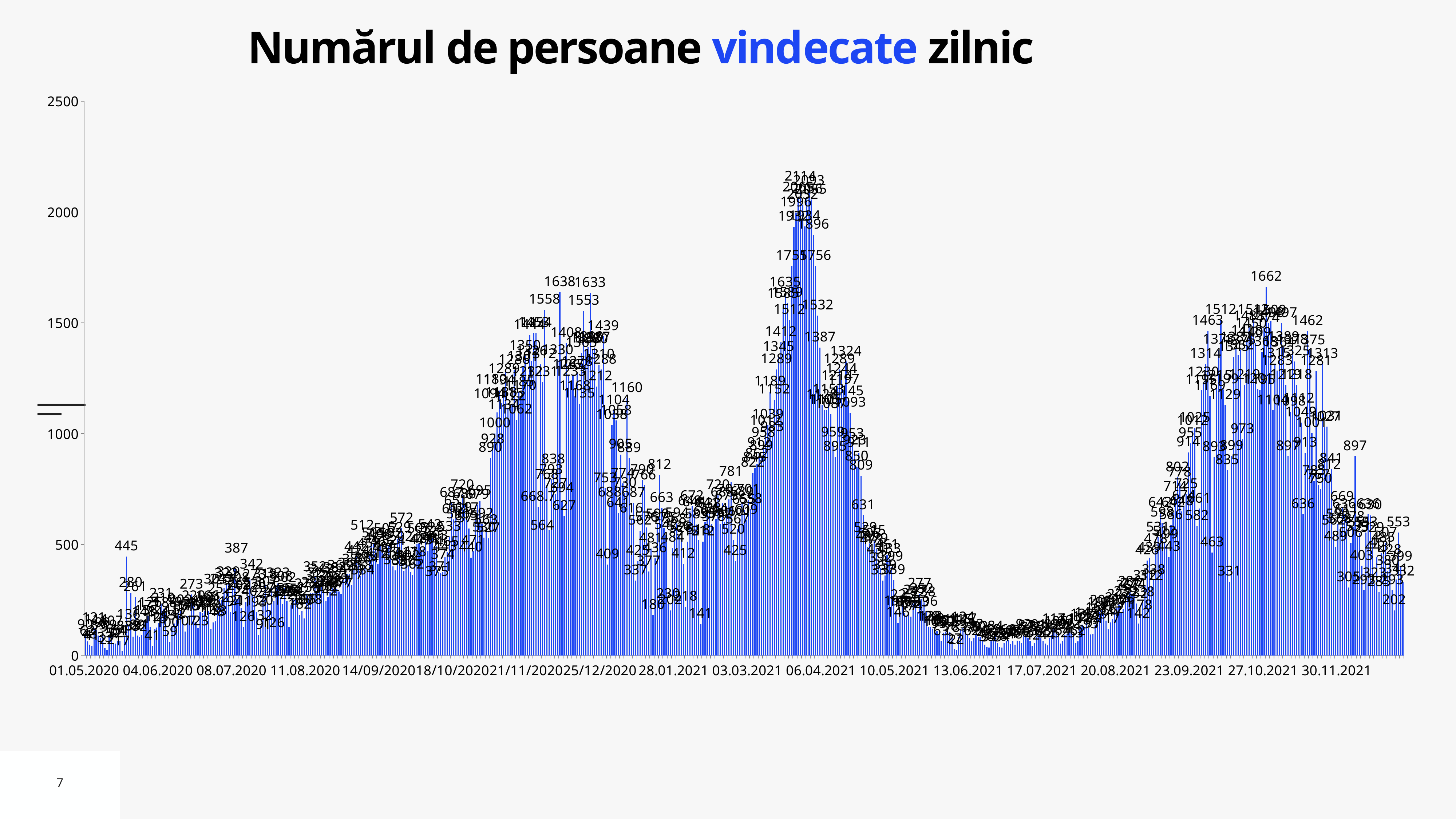
What is the title of the chart? Numărul de persoane vindecate zilnic Do the values rise or fall between 20.08.2021 and 27.10.2021? rise Is the highest value around 06.04.2021 greater or less than 2000? greater What is the highest value labelled in the peak around 27.10.2021? 1662 Are the values around 17.07.2021 greater or less than 500? less Do the values rise or fall between 06.04.2021 and 13.06.2021? fall Is the highest value around 27.10.2021 greater or less than 2000? less What kind of chart is shown on the slide? bar chart What is the maximum value shown on the vertical axis? 2500 What is the highest daily value labelled on the chart? 2114 What is the difference between the highest labelled value of the April 2021 peak (2114) and the highest labelled value of the October 2021 peak (1662)? 452 Which peak is higher: the one around 06.04.2021 or the one around 27.10.2021? the one around 06.04.2021